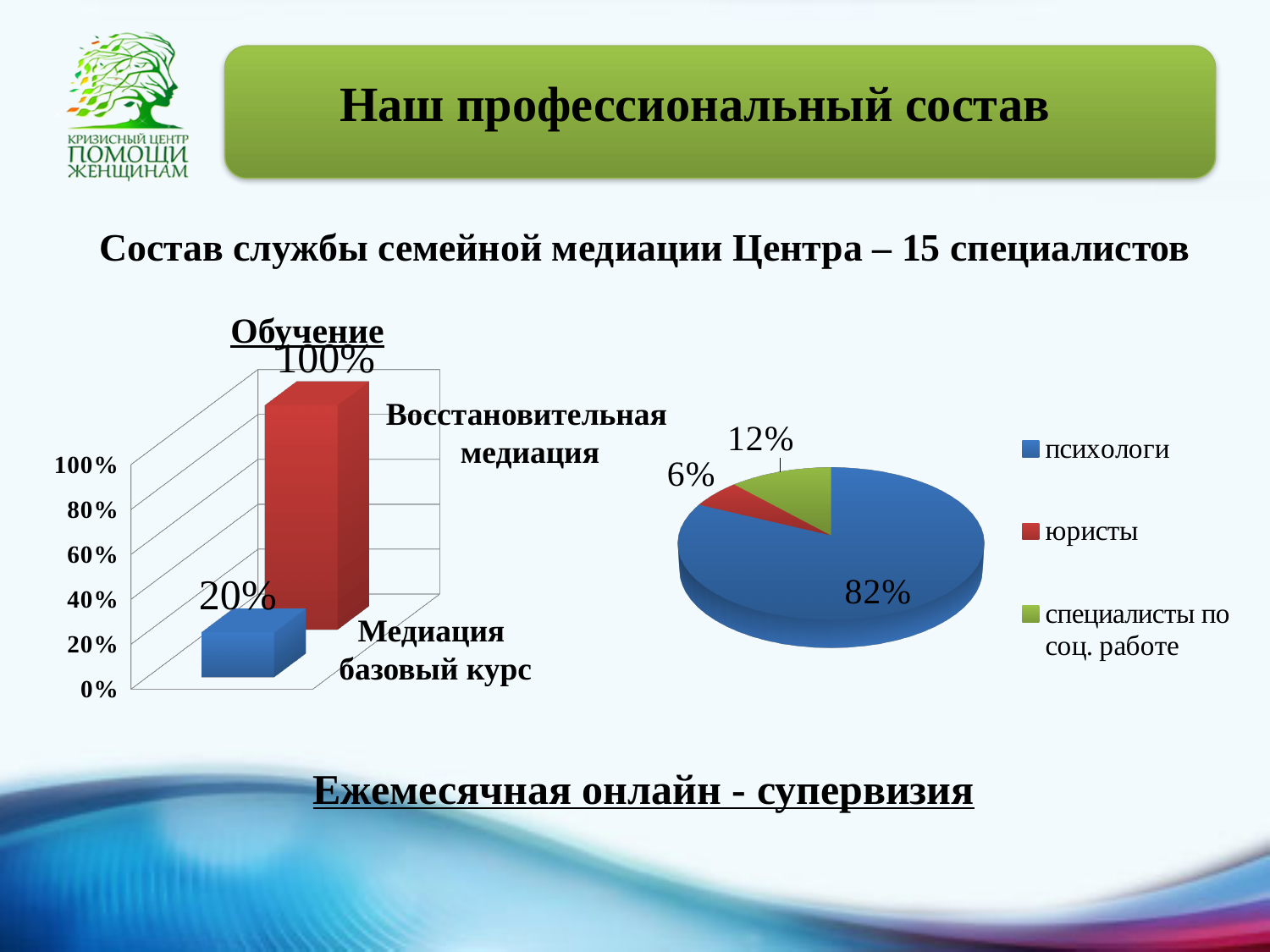
In the pie chart on the right, what share is shown for "психологи"? 82% In the pie chart on the right, how many entries does the legend list? 3 In the bar chart titled "Обучение", which category has the highest value? Восстановительная медиация In the pie chart on the right, which is larger: the slice for "специалисты по соц. работе" or the slice for "юристы"? специалисты по соц. работе What kind of chart is the chart titled "Обучение" on the left of the slide? bar chart In the bar chart titled "Обучение", what is the value for "Восстановительная медиация"? 100% In the pie chart on the right, which category has the smallest slice? юристы In the bar chart titled "Обучение", how many bars are plotted? 2 In the pie chart on the right, what share is shown for "специалисты по соц. работе"? 12% In the bar chart titled "Обучение", what is the value for "Медиация базовый курс"? 20% In the pie chart on the right, what share is shown for "юристы"? 6% In the bar chart titled "Обучение", what is the difference between the values for "Восстановительная медиация" and "Медиация базовый курс"? 80%